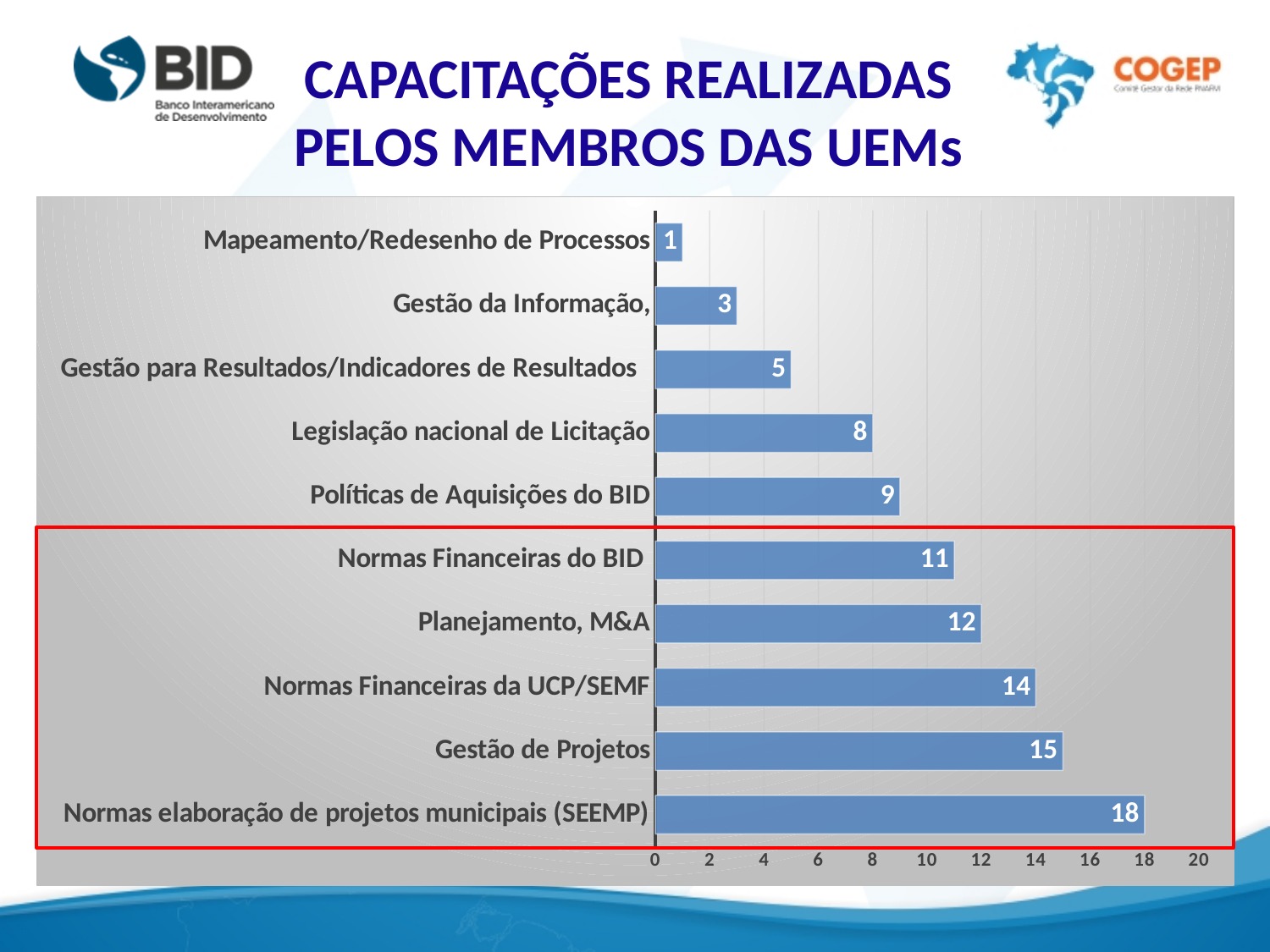
How many categories are enclosed by the red rectangle on the chart? 5 How many categories are shown in the chart? 10 What is the value for Gestão de Projetos? 15 What is the difference between the values for Normas elaboração de projetos municipais (SEEMP) and Gestão de Projetos? 3 Which category has the lowest value? Mapeamento/Redesenho de Processos What is the value for Legislação nacional de Licitação? 8 What is the difference between the values for Políticas de Aquisições do BID and Gestão da Informação? 6 Which is larger, the value for Planejamento, M&A or the value for Normas Financeiras do BID? Planejamento, M&A Which category has the highest value? Normas elaboração de projetos municipais (SEEMP) What is the value for Normas Financeiras da UCP/SEMF? 14 What kind of chart is shown on the slide? bar chart Is the value for Gestão para Resultados/Indicadores de Resultados greater or less than 10? less